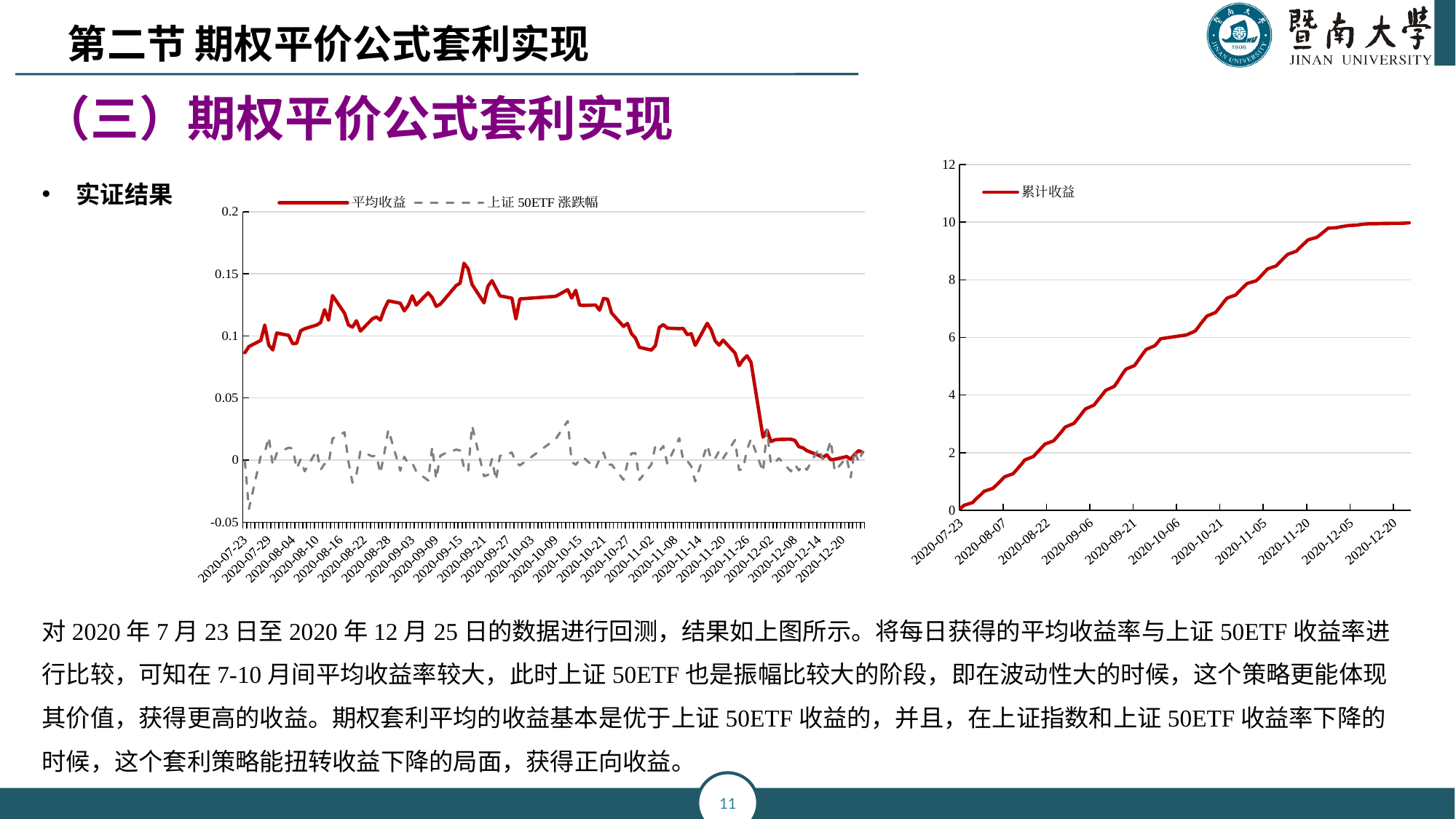
In the right chart, is the value of 累计收益 at 2020-08-22 greater or less than 4? less What is the name of the series plotted in the right chart? 累计收益 What kind of chart is the right chart (累计收益) on the slide? line chart In the right chart, is the value of 累计收益 at 2020-12-20 greater or less than 8? greater In the left chart, is the value of 平均收益 at 2020-12-20 greater or less than 0.05? less In the left chart, which series is drawn with a dashed gray line? 上证 50ETF 涨跌幅 How many series does the legend of the left chart list? 2 How many series does the legend of the right chart list? 1 In the left chart, which series is higher around 2020-09-15, 平均收益 or 上证 50ETF 涨跌幅? 平均收益 What kind of chart is the left chart on the slide? line chart In the right chart, does the 累计收益 line rise or fall from 2020-07-23 to 2020-12-20? rise